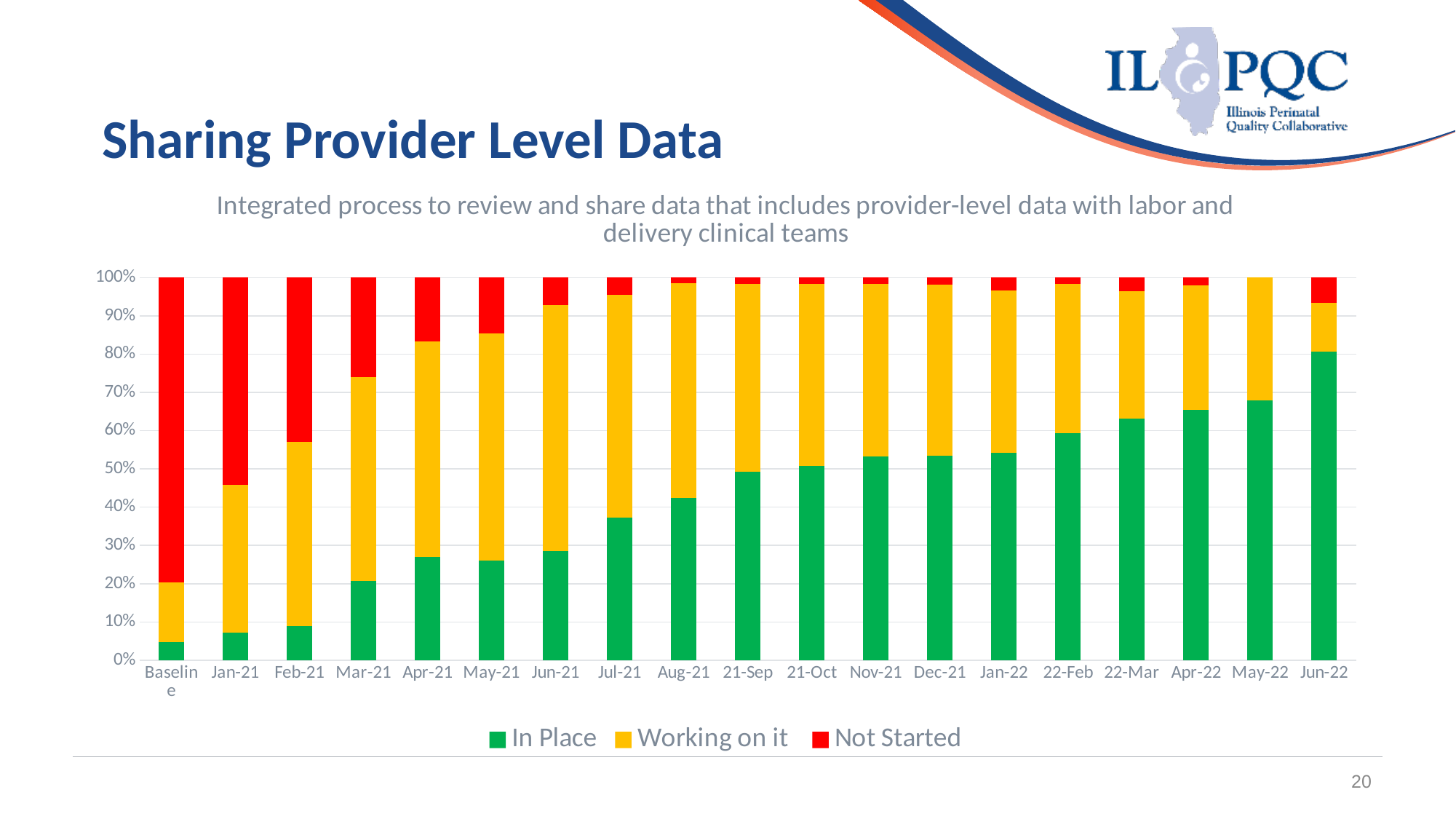
How many time-period categories are shown along the x axis? 19 Is the 'Not Started' value for Baseline greater or less than 70%? greater Which category has the largest 'Not Started' share? Baseline Does the 'In Place' share generally rise or fall from Baseline to Jun-22? rise Is the 'In Place' value for Jun-22 greater or less than 70%? greater What kind of chart is shown on the slide? Stacked bar chart How many series does the legend list? 3 Which category has the highest 'In Place' share? Jun-22 Is the 'In Place' value for Baseline greater or less than 10%? less Which is larger, the 'In Place' share for Jun-22 or for Jan-21? Jun-22 Which colour represents the 'Working on it' series in the legend? Yellow Which category has the lowest 'In Place' share? Baseline